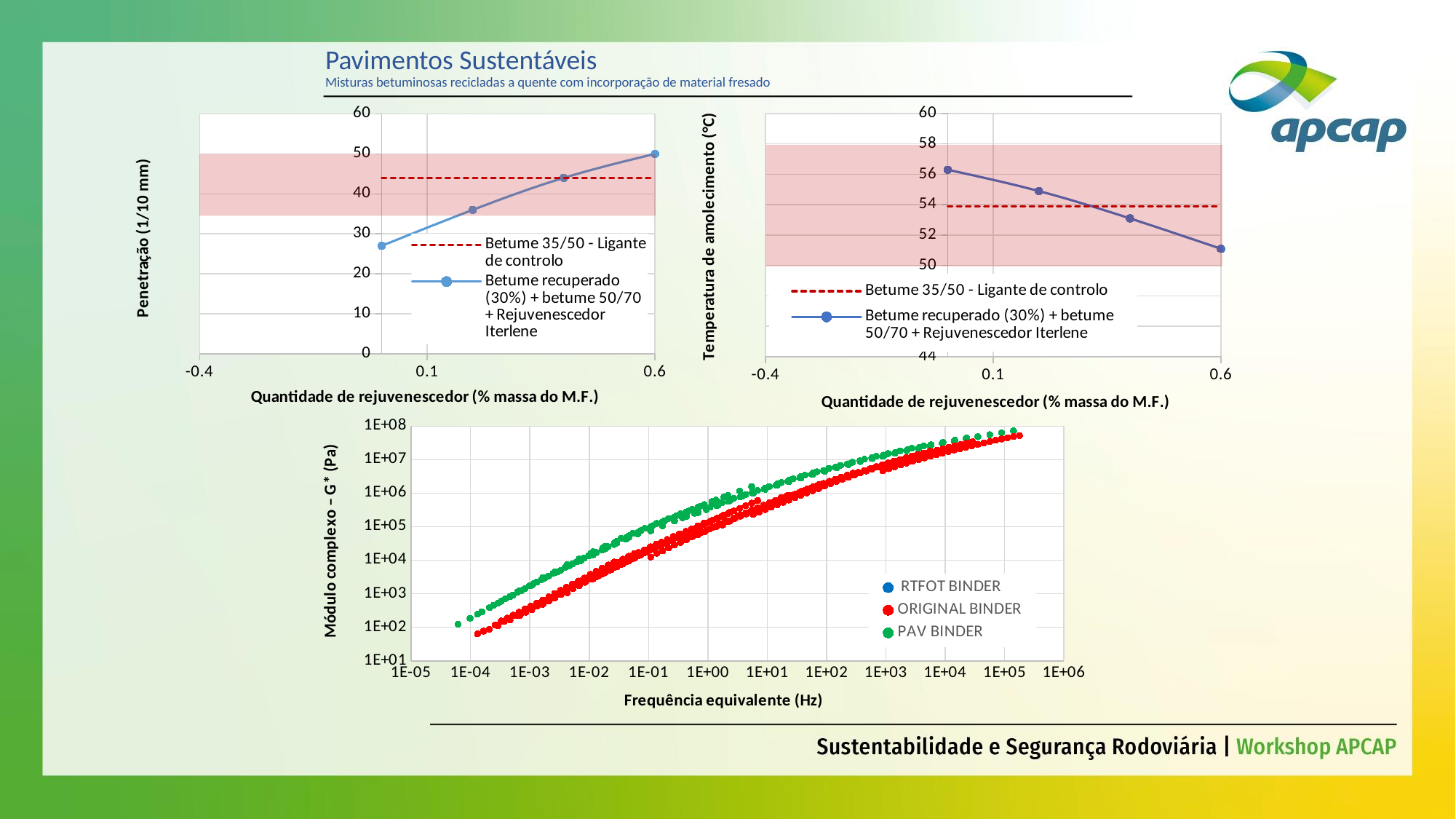
In the top-left chart (Penetração), do the values of the 'Betume recuperado (30%) + betume 50/70 + Rejuvenescedor Iterlene' series rise or fall as the quantity of rejuvenator increases? rise In the top-left chart (Penetração), is the first (leftmost) plotted value of the 'Betume recuperado' series greater or less than 30? less In the bottom chart (Módulo complexo), how many series does the legend list? 3 In the top-left chart (Penetração), how many series does the legend list? 2 In the top-right chart (Temperatura de amolecimento), do the values of the 'Betume recuperado (30%) + betume 50/70 + Rejuvenescedor Iterlene' series rise or fall as the quantity of rejuvenator increases? fall In the bottom chart (Módulo complexo), what is the label of the x axis? Frequência equivalente (Hz) In the top-left chart (Penetração), how many data points are plotted for the 'Betume recuperado (30%) + betume 50/70 + Rejuvenescedor Iterlene' series? 4 In the top-left chart (Penetração), is the value of the 'Betume 35/50 - Ligante de controlo' dashed line greater or less than 40? greater What kind of chart is the top-left chart (Penetração)? line chart In the top-right chart (Temperatura de amolecimento), how many series does the legend list? 2 In the top-right chart (Temperatura de amolecimento), is the last (rightmost) plotted value of the 'Betume recuperado' series greater or less than 52? less